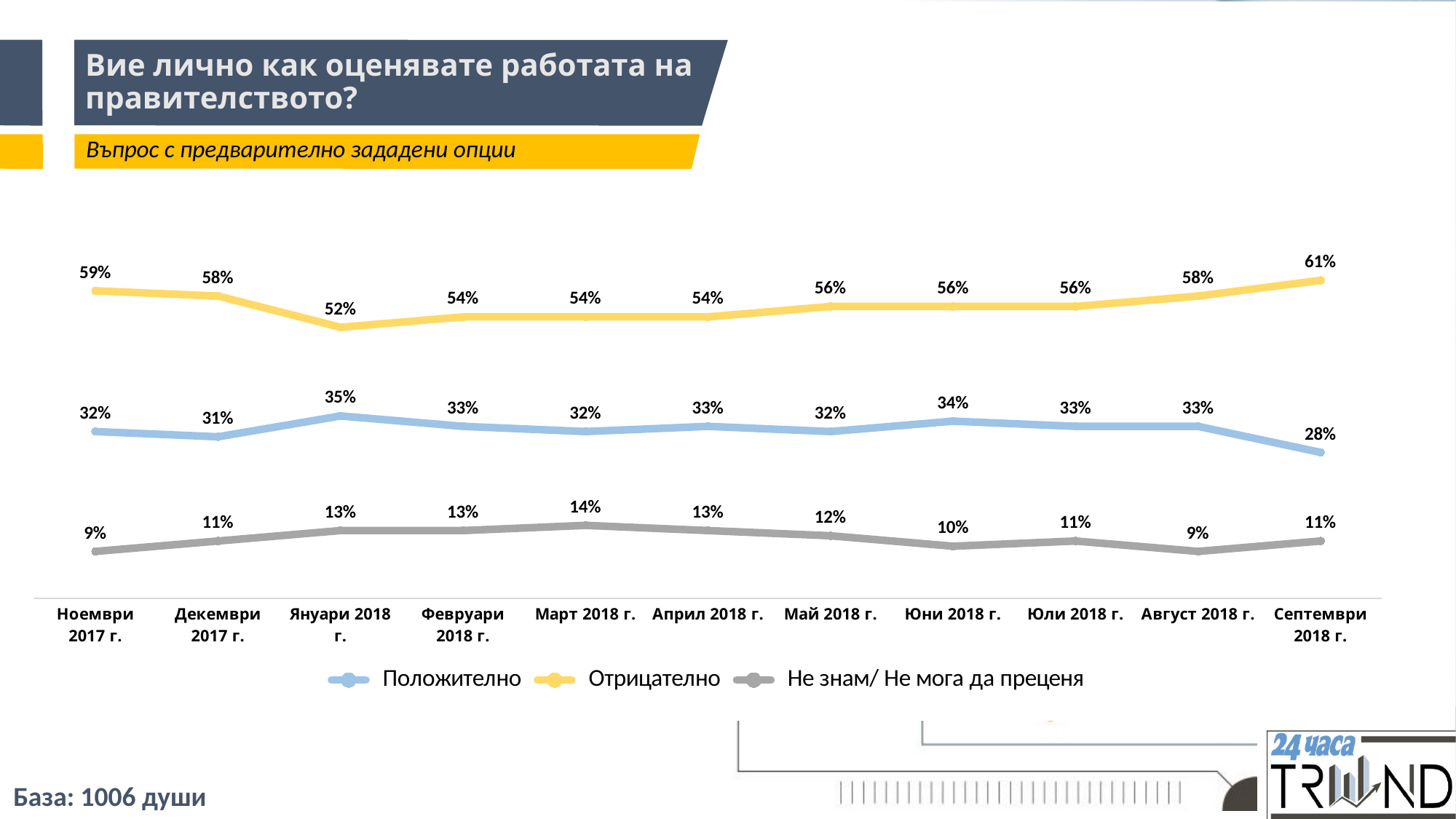
What colour is the line for Отрицателно? Yellow What is the value for Отрицателно in Септември 2018 г.? 61% What is the difference between Отрицателно and Положително in Септември 2018 г.? 33 percentage points Does the Отрицателно series rise or fall from Май 2018 г. to Септември 2018 г.? Rise What is the value for Положително in Януари 2018 г.? 35% In which month does the Отрицателно series reach its lowest value? Януари 2018 г. What is the value for Не знам/ Не мога да преценя in Март 2018 г.? 14% In which month does the Положително series reach its lowest value? Септември 2018 г. What kind of chart is shown on the slide? Line chart How many time points are shown on the x axis? 11 Which is larger in Ноември 2017 г.: Положително or Не знам/ Не мога да преценя? Положително How many series does the legend list? 3